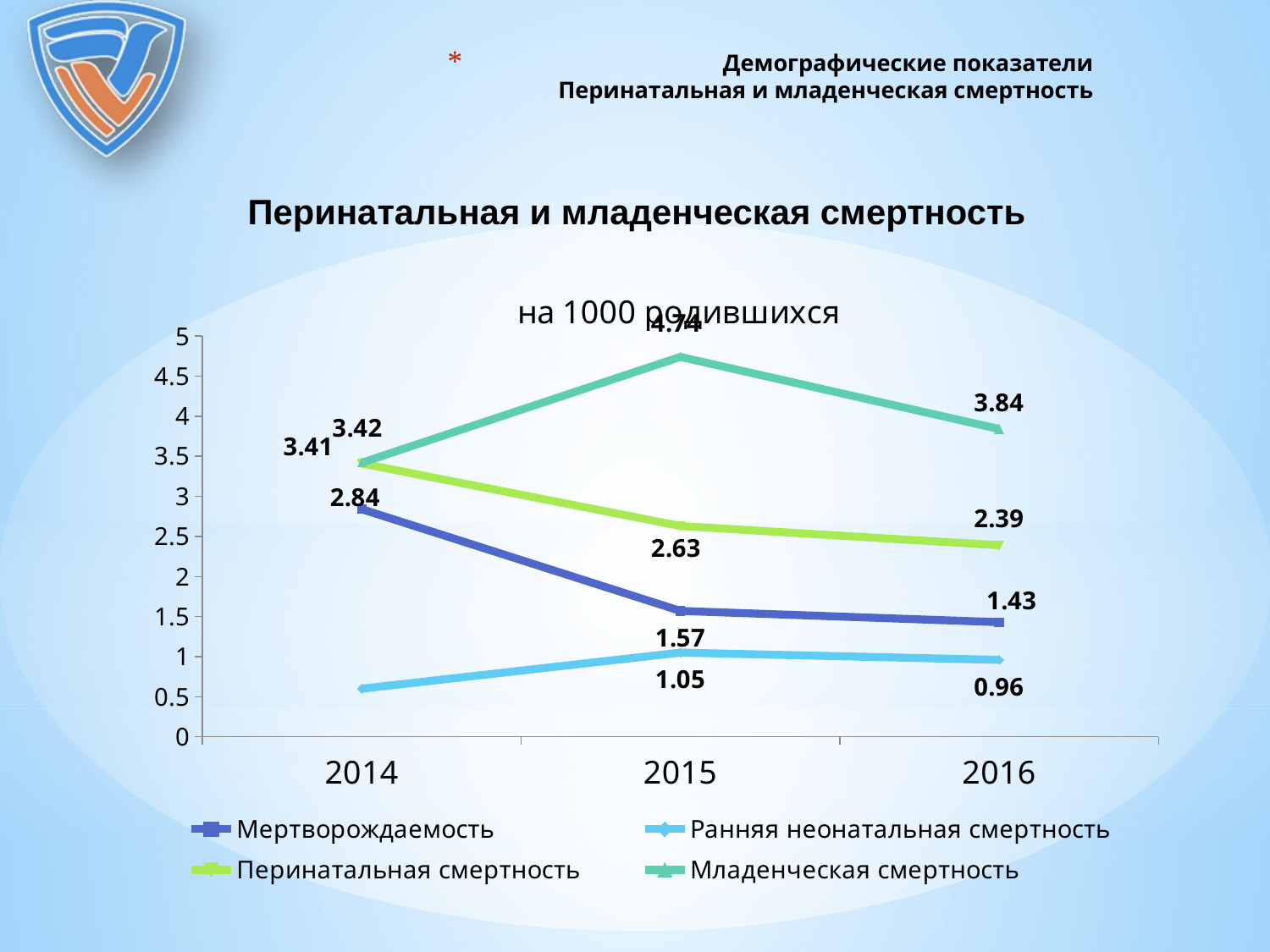
What is the value of Мертворождаемость in 2016? 1.43 By how much did Мертворождаемость decrease from 2014 to 2016? 1.41 What is the value of Ранняя неонатальная смертность in 2016? 0.96 Does Мертворождаемость rise or fall from 2014 to 2016? fall What is the value of Младенческая смертность in 2015? 4.74 How many years are shown on the x axis? 3 In 2016, which is larger: Перинатальная смертность or Мертворождаемость? Перинатальная смертность Is the value for Ранняя неонатальная смертность in 2014 greater or less than 1? less How many series does the legend list? 4 What kind of chart is shown on the slide? line chart What is the value of Перинатальная смертность in 2015? 2.63 In which year is Младенческая смертность highest? 2015